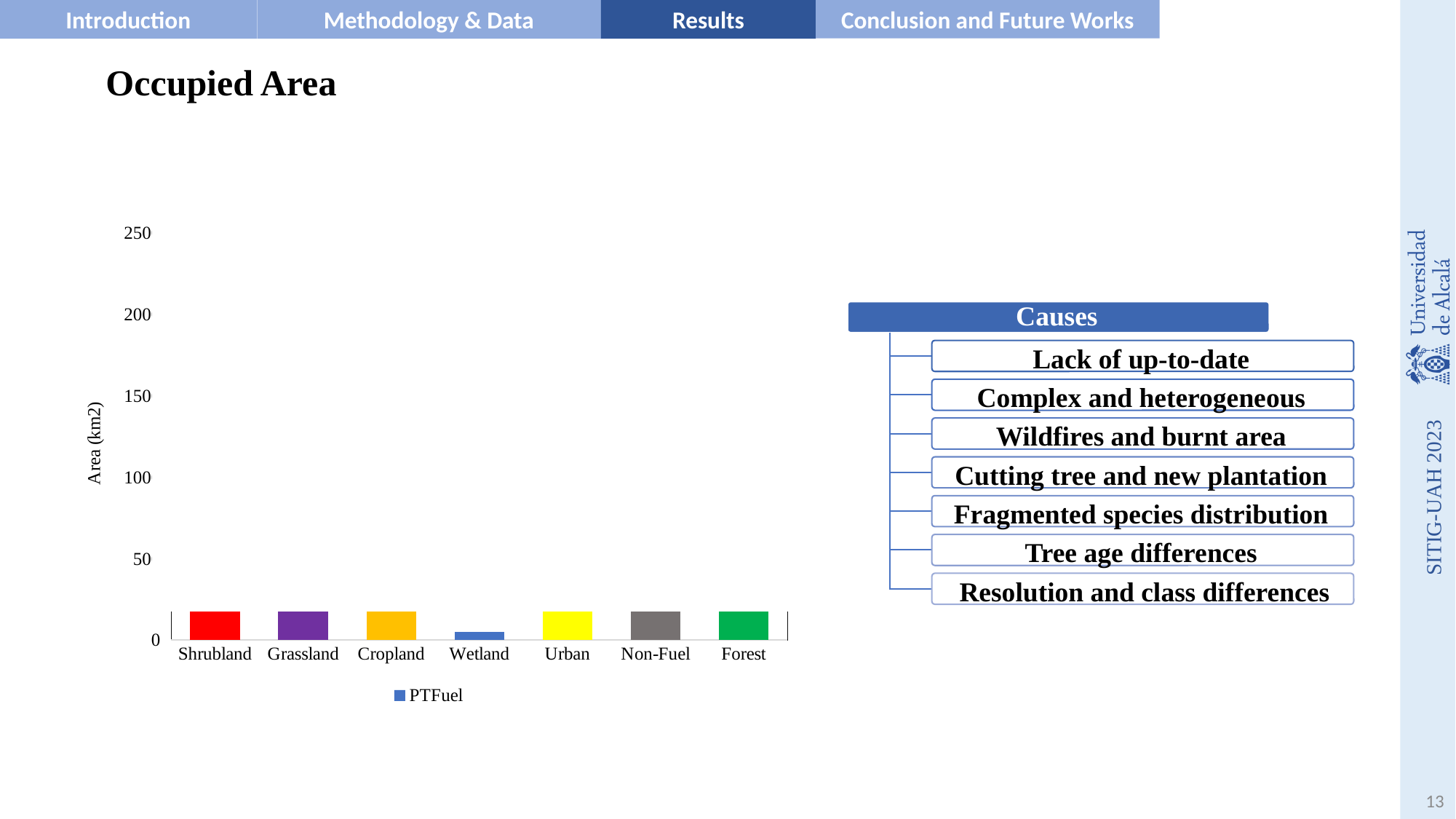
Which is larger, the value for Wetland or the value for Urban? Urban Is the value for Forest greater or less than 100? less How many categories are shown on the x axis of the chart? 7 What series name is shown in the chart's legend? PTFuel What kind of chart is shown on the slide? bar chart What is the label of the y axis of the chart? Area (km2) How many series does the chart's legend list? 1 Is the value for Shrubland greater or less than 50? less Which is larger, the value for Shrubland or the value for Wetland? Shrubland Which category has the lowest value in the chart? Wetland Is the value for Wetland greater or less than 50? less